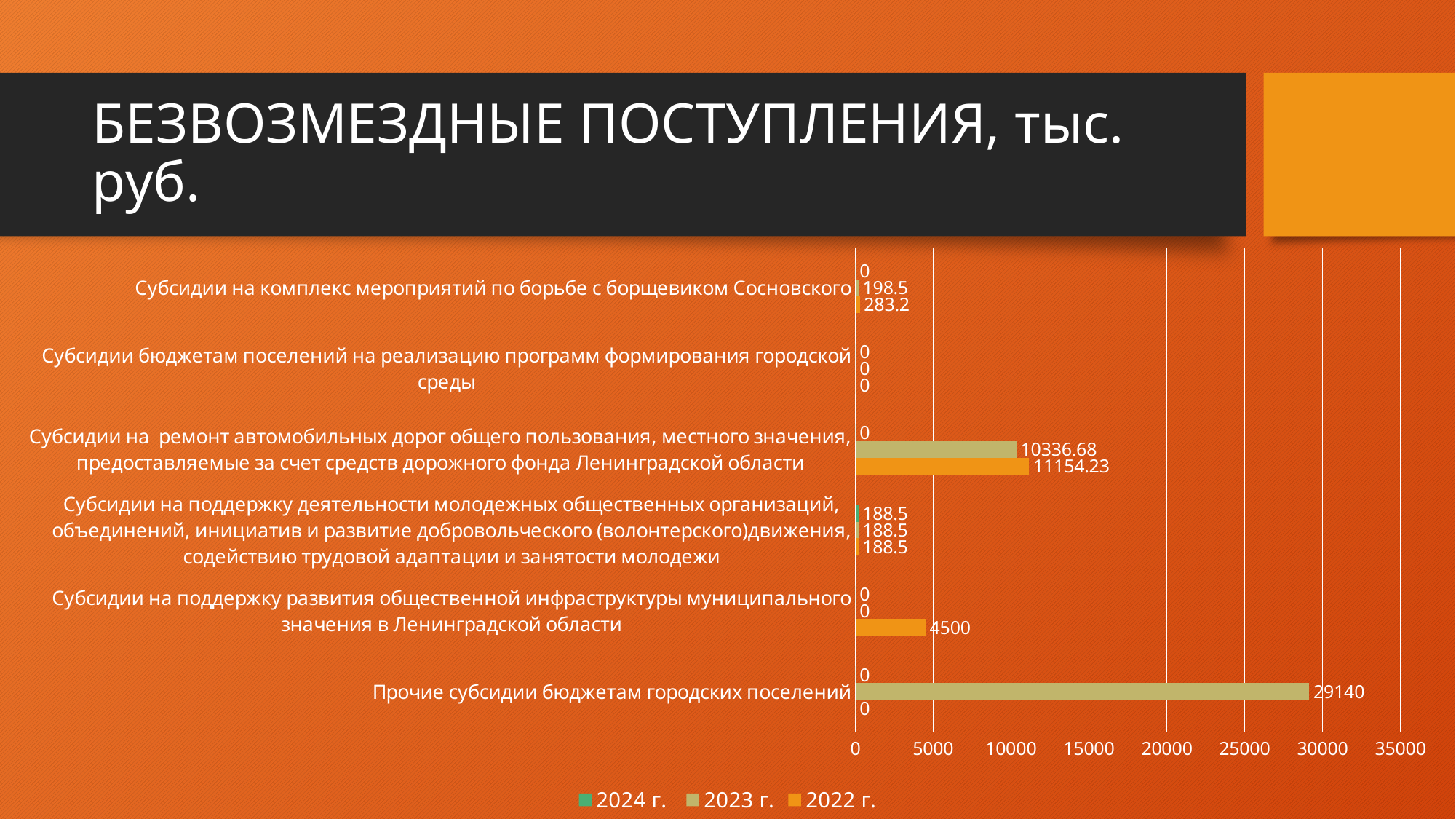
What is the 2023 г. value for "Субсидии на комплекс мероприятий по борьбе с борщевиком Сосновского"? 198.5 How many categories are shown on the chart? 6 What is the 2022 г. value for "Субсидии на ремонт автомобильных дорог общего пользования, местного значения, предоставляемые за счет средств дорожного фонда Ленинградской области"? 11154.23 Is the 2023 г. value for "Прочие субсидии бюджетам городских поселений" greater or less than 25000? greater Which category has the highest 2023 г. value? Прочие субсидии бюджетам городских поселений What is the 2023 г. value for "Прочие субсидии бюджетам городских поселений"? 29140 What is the 2022 г. value for "Субсидии на поддержку развития общественной инфраструктуры муниципального значения в Ленинградской области"? 4500 What kind of chart is shown on the slide? bar chart For "Субсидии на комплекс мероприятий по борьбе с борщевиком Сосновского", which is larger: the 2022 г. value or the 2023 г. value? 2022 г. How many series does the legend list? 3 What is the 2024 г. value for "Субсидии на поддержку деятельности молодежных общественных организаций, объединений, инициатив и развитие добровольческого (волонтерского)движения, содействию трудовой адаптации и занятости молодежи"? 188.5 What is the difference between the 2022 г. and 2023 г. values for "Субсидии на ремонт автомобильных дорог общего пользования, местного значения, предоставляемые за счет средств дорожного фонда Ленинградской области"? 817.55